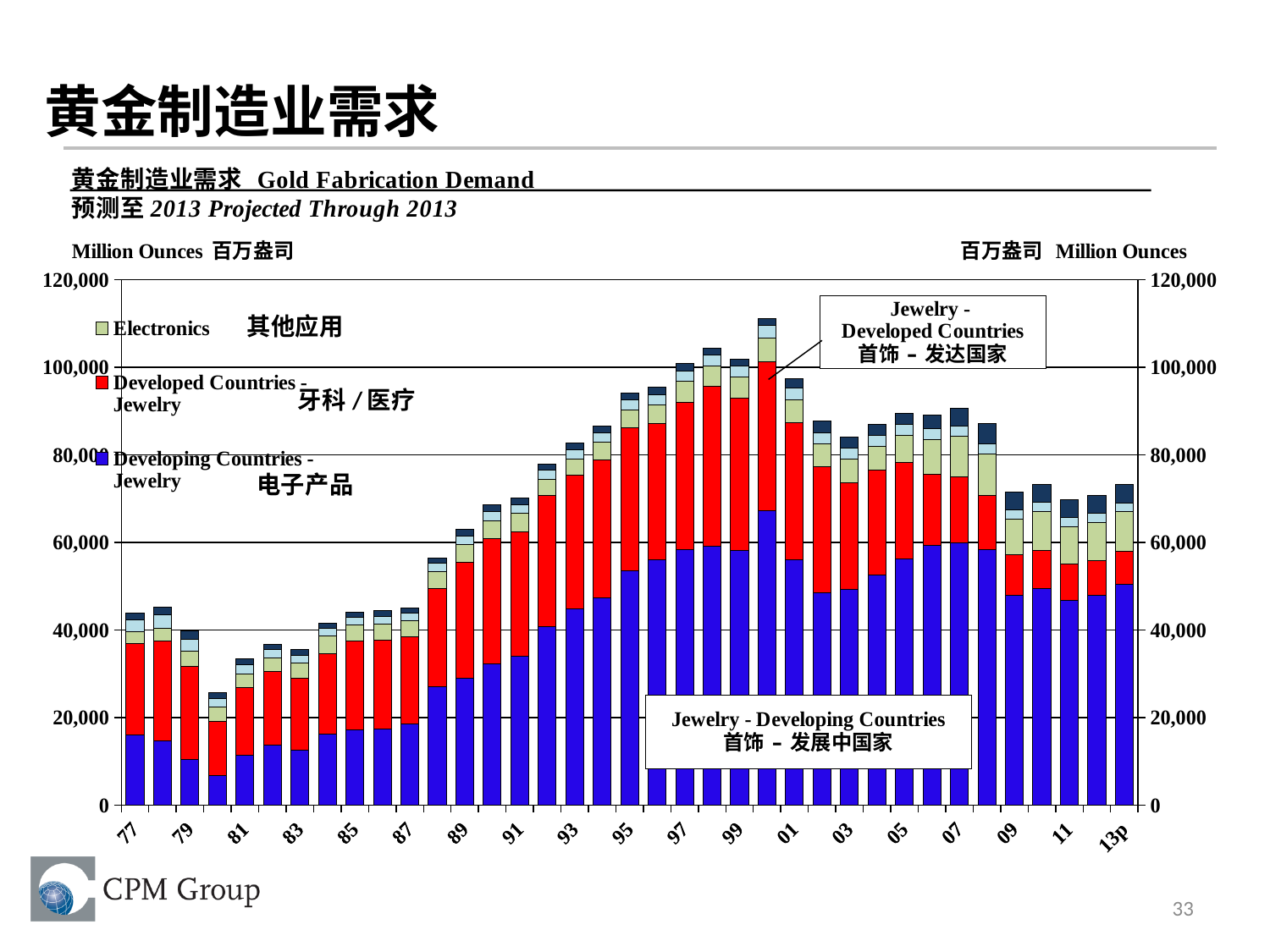
Which year has a larger total bar, 80 or 90? 90 What is the English title of the chart? Gold Fabrication Demand Is the total bar height for 13p greater or less than 80,000? less What unit is shown on the vertical axis of the chart? Million Ounces What kind of chart is shown on the slide? Stacked bar chart Is the total bar height for the year 80 greater or less than 40,000? less Is the total bar height for the year 00 greater or less than 100,000? greater Which year has a larger total bar, 00 or 13p? 00 Which year has the tallest stacked bar (highest total gold fabrication demand)? 00 Do the total bar heights generally rise or fall from 80 to 00? rise Which year has the shortest stacked bar (lowest total gold fabrication demand)? 80